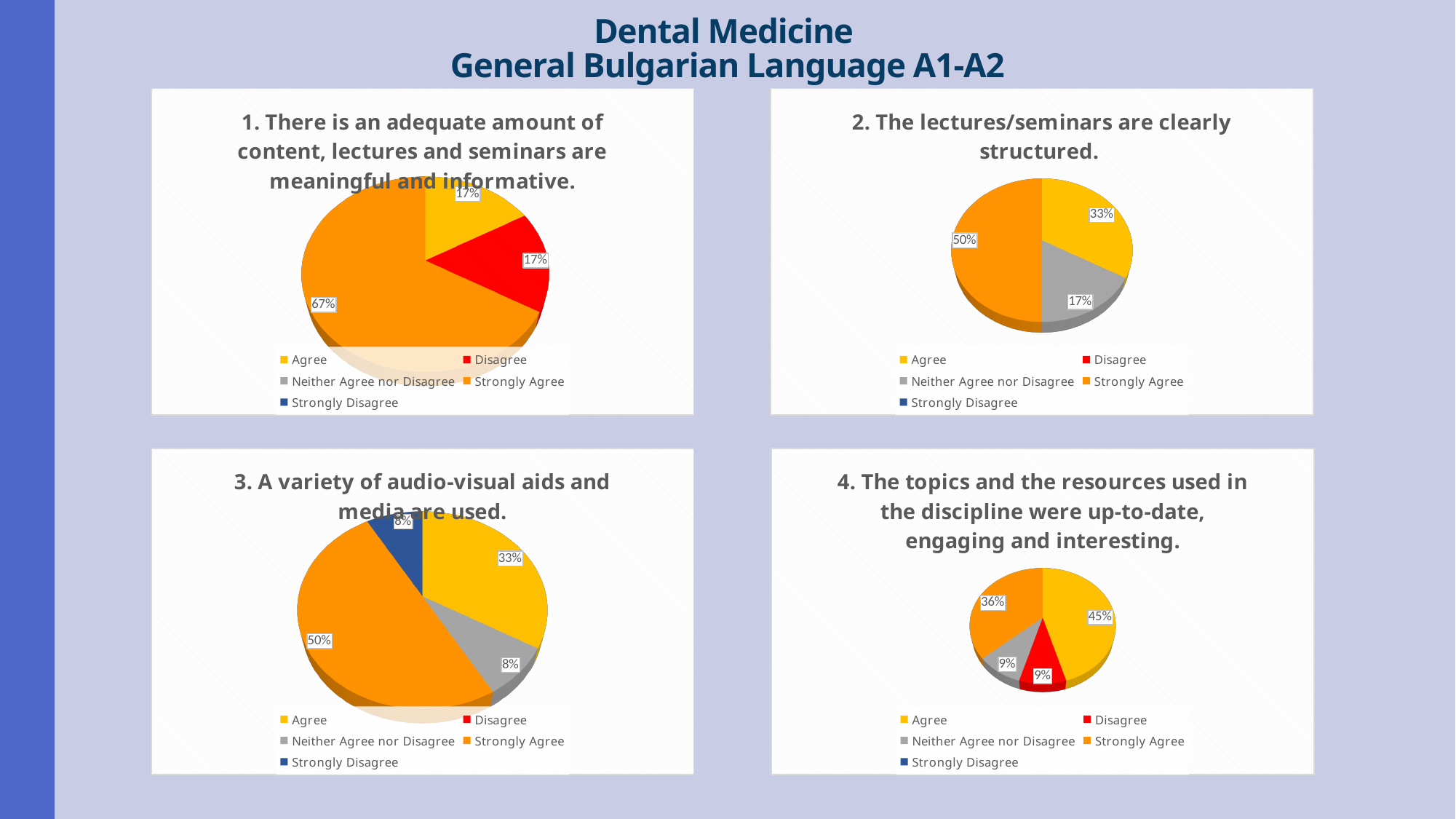
In the chart titled "4. The topics and the resources used in the discipline were up-to-date, engaging and interesting.", which is larger, Agree or Strongly Agree? Agree In the chart titled "3. A variety of audio-visual aids and media are used.", what percentage is Strongly Disagree? 8% In the chart titled "4. The topics and the resources used in the discipline were up-to-date, engaging and interesting.", what percentage is Agree? 45% In the chart titled "2. The lectures/seminars are clearly structured.", which response has the largest share? Strongly Agree In the chart titled "1. There is an adequate amount of content, lectures and seminars are meaningful and informative.", what percentage is Disagree? 17% How many entries does the legend of the chart titled "3. A variety of audio-visual aids and media are used." list? 5 In the chart titled "3. A variety of audio-visual aids and media are used.", what percentage is Strongly Agree? 50% In the chart titled "1. There is an adequate amount of content, lectures and seminars are meaningful and informative.", what percentage is Strongly Agree? 67% In the chart titled "4. The topics and the resources used in the discipline were up-to-date, engaging and interesting.", what percentage is Disagree? 9% In the chart titled "2. The lectures/seminars are clearly structured.", what percentage is Agree? 33% What type of chart is used in the top-left chart on the slide? Pie chart In the chart titled "2. The lectures/seminars are clearly structured.", what is the difference between the Strongly Agree and Neither Agree nor Disagree shares? 33%